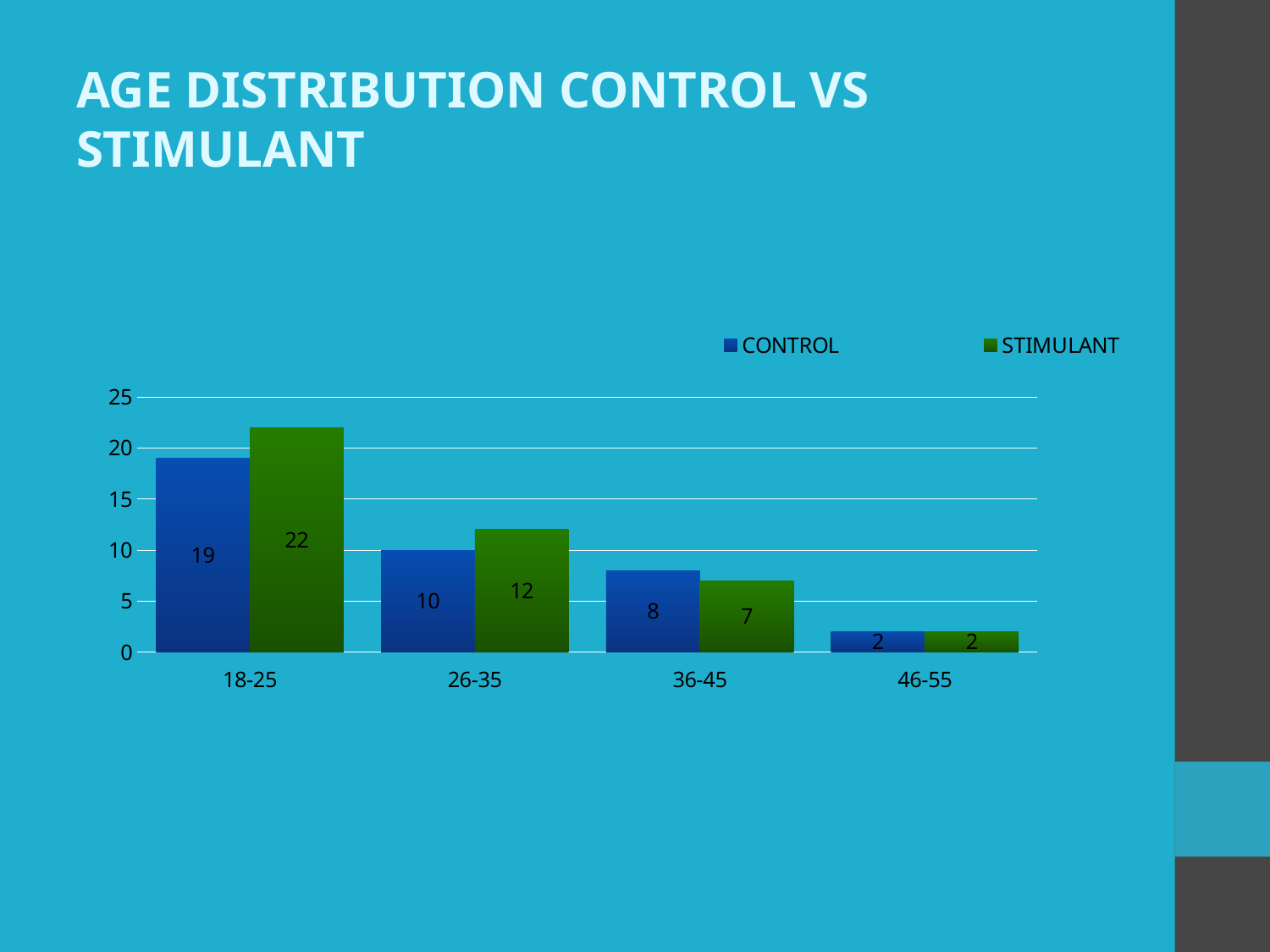
Which age group has the lowest CONTROL value? 46-55 What is the STIMULANT value for the 36-45 age group? 7 Which age group has the highest STIMULANT value? 18-25 Is the STIMULANT value for 18-25 greater or less than 20? greater What is the difference between the STIMULANT and CONTROL values for the 18-25 age group? 3 What is the STIMULANT value for the 26-35 age group? 12 How many series does the legend list? 2 Do the CONTROL values rise or fall from 18-25 to 46-55? Fall How many age groups are shown on the x axis? 4 What kind of chart is shown on the slide? Bar chart What is the CONTROL value for the 18-25 age group? 19 Which is larger for the 36-45 age group, CONTROL or STIMULANT? CONTROL